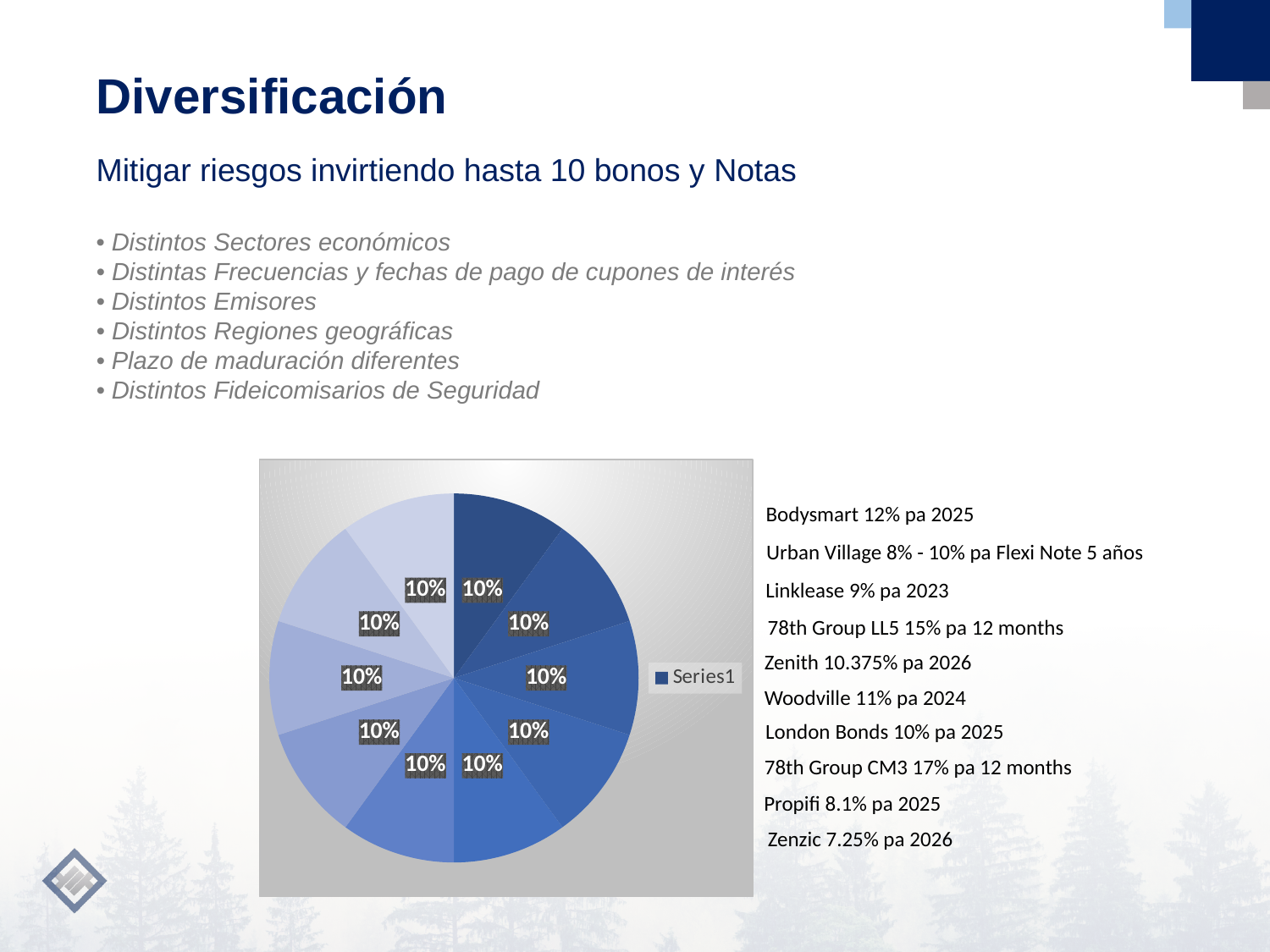
What is the combined share of two slices of the pie chart? 20% What is the name of the series shown in the pie chart's legend? Series1 Are all the slices of the pie chart the same size? Yes What percentage is shown on each slice of the pie chart? 10% How many slices does the pie chart have? 10 How many series does the legend of the pie chart list? 1 What kind of chart is shown on the slide? pie chart What is the difference in share between any two slices of the pie chart? 0% How many bonds and notes are listed in the text to the right of the pie chart? 10 What is the total share of all slices in the pie chart combined? 100% Is the share of any single slice in the pie chart greater or less than 20%? less